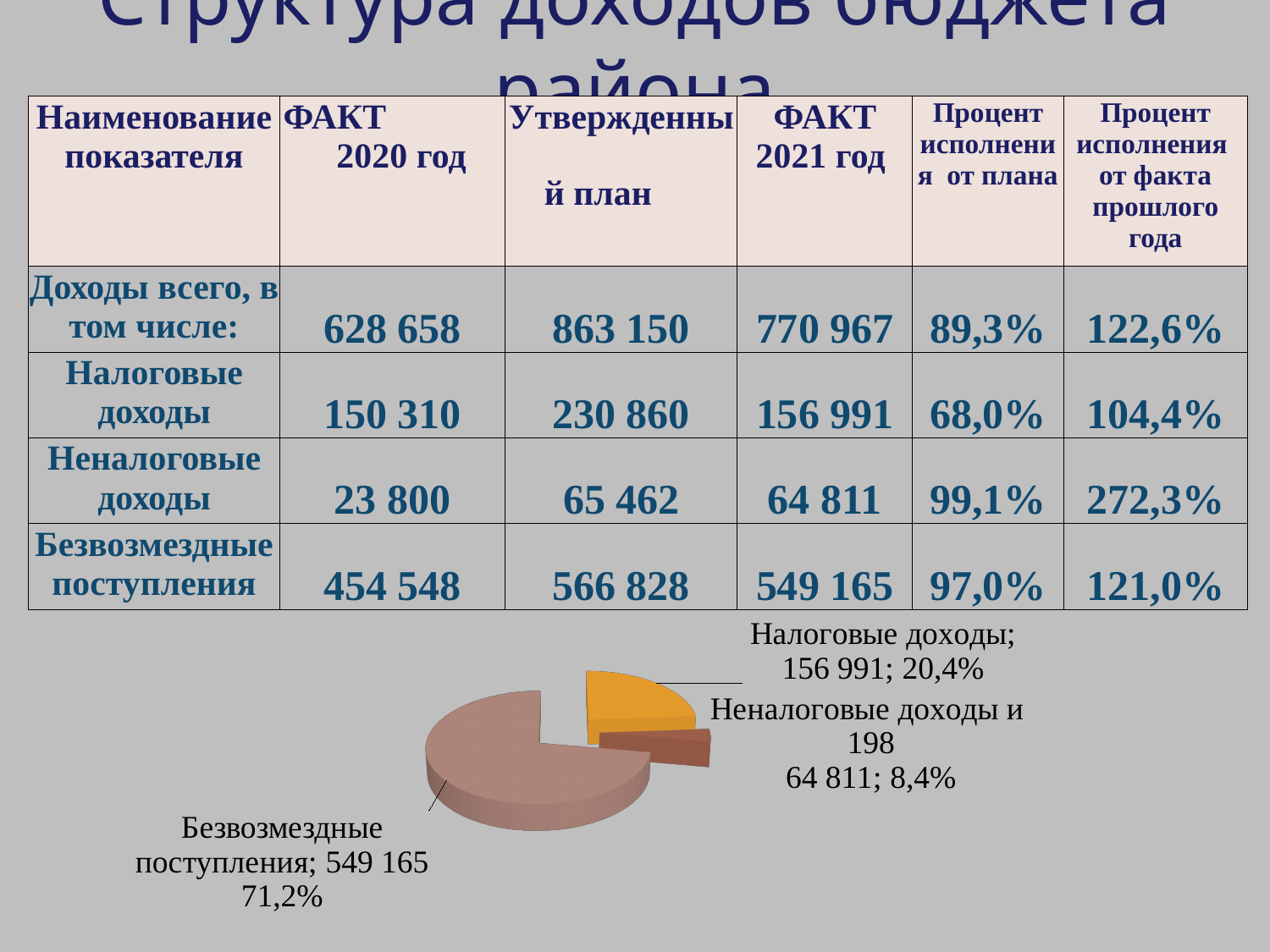
What share of the pie does Безвозмездные поступления take? 71,2% What kind of chart is shown at the bottom of the slide? pie chart Which slice of the pie chart is the smallest? Неналоговые доходы In the pie chart, what is the difference between the values for Безвозмездные поступления and Налоговые доходы? 392 174 In the pie chart, what value is shown for Безвозмездные поступления? 549 165 What share of the pie does Налоговые доходы take? 20,4% In the pie chart, what value is shown for Неналоговые доходы? 64 811 In the pie chart, which is larger: Налоговые доходы or Неналоговые доходы? Налоговые доходы Which slice of the pie chart is the largest? Безвозмездные поступления How many slices does the pie chart have? 3 What share of the pie does Неналоговые доходы take? 8,4% In the pie chart, what value is shown for Налоговые доходы? 156 991